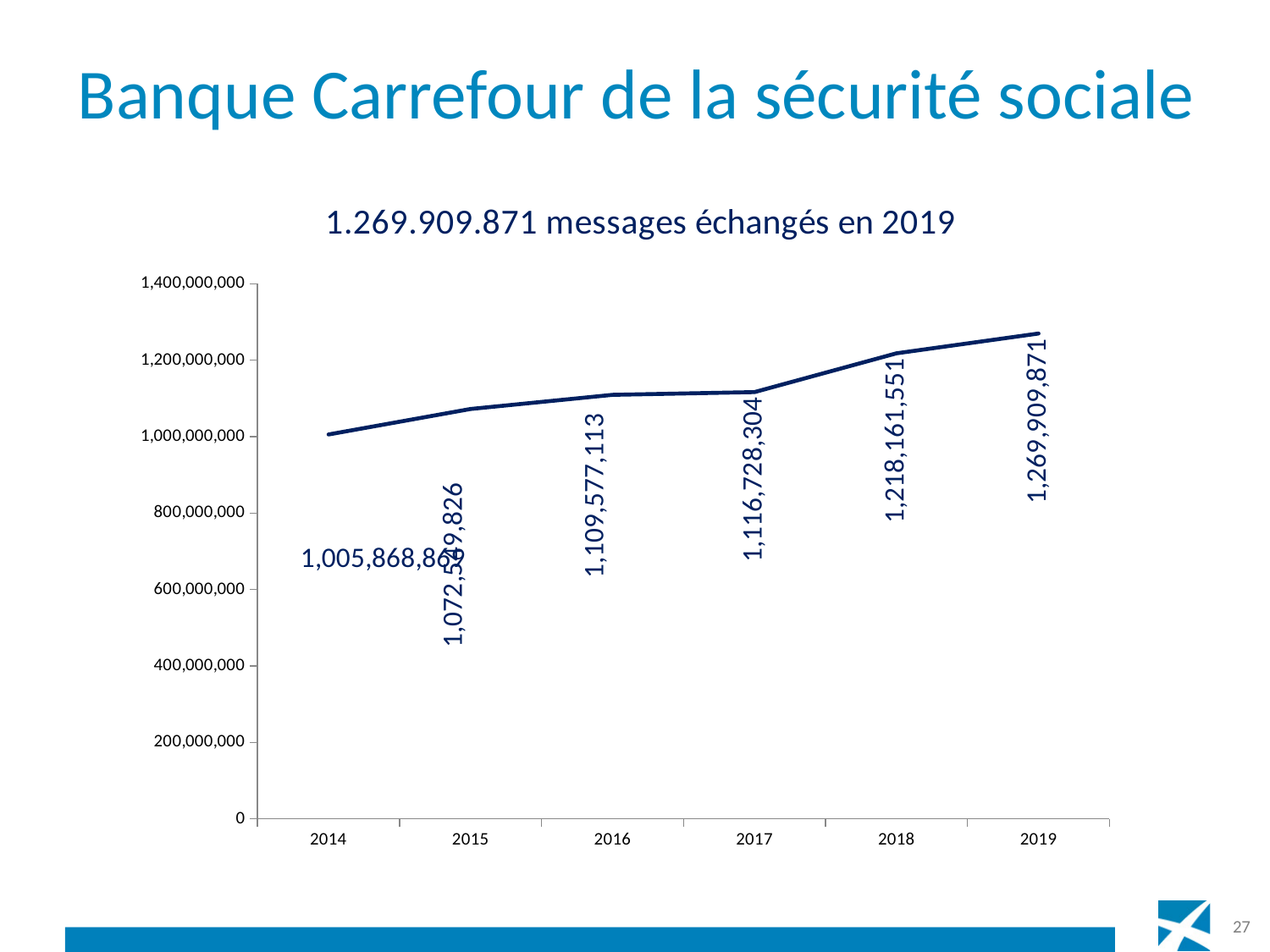
What is the difference between the values for 2018 and 2017? 101,433,247 Which year has the highest value? 2019 Which year has the lowest value? 2014 What is the value for 2016? 1,109,577,113 Is the value for 2015 greater or less than 1,000,000,000? greater What type of chart is shown on the slide? Line chart What is the difference between the values for 2019 and 2018? 51,748,320 What is the value for 2017? 1,116,728,304 What is the value for 2018? 1,218,161,551 Do the values rise or fall from 2014 to 2019? rise What is the value for 2019? 1,269,909,871 How many years are plotted on the x axis? 6